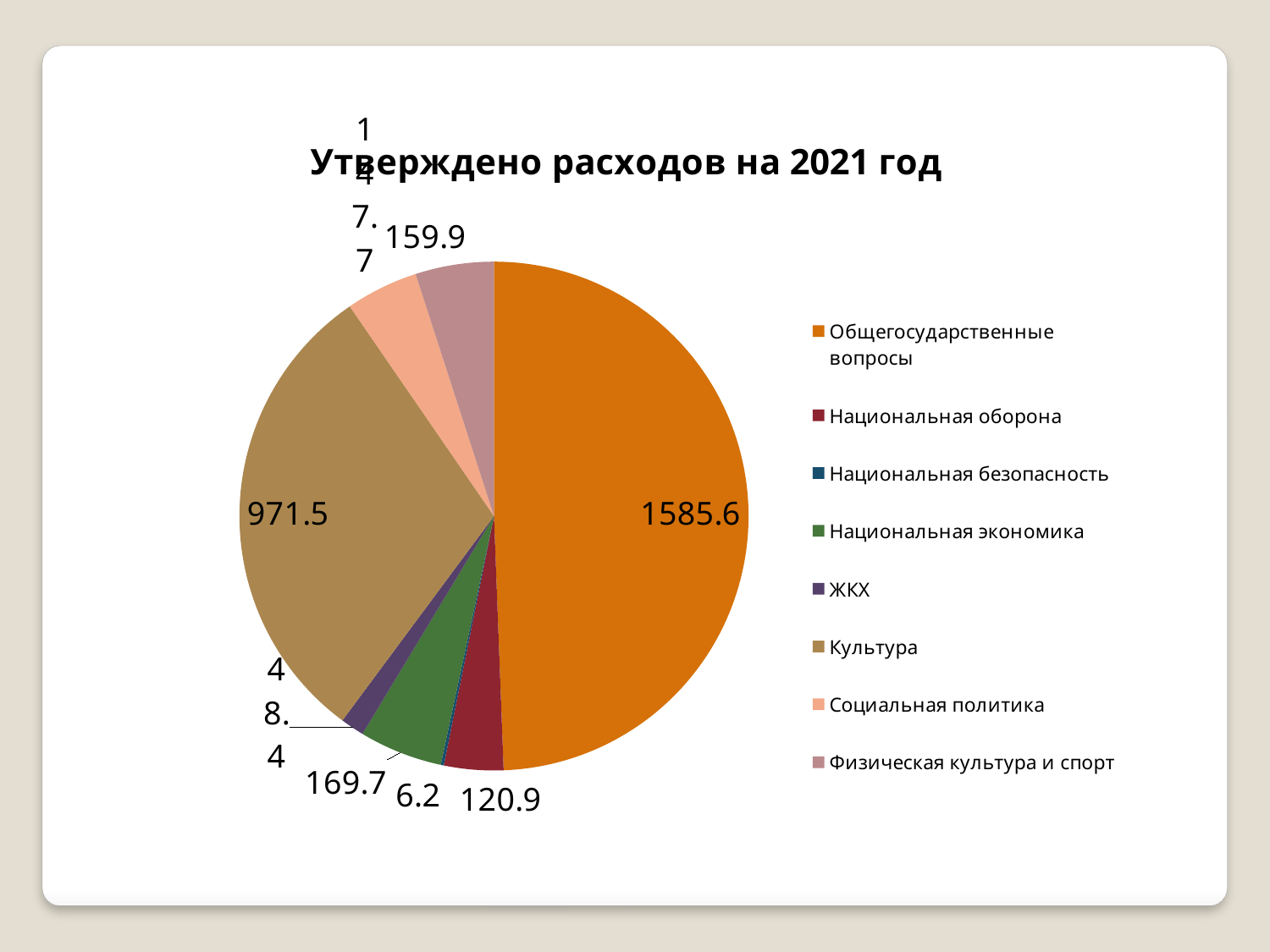
Which is larger, Национальная экономика or Национальная оборона? Национальная экономика How many categories does the legend list? 8 What is the difference between Общегосударственные вопросы and Культура? 614.1 What kind of chart is shown on the slide? pie chart Which category has the largest slice? Общегосударственные вопросы Which category has the smallest slice? Национальная безопасность What is the value for Национальная оборона? 120.9 What is the value for Культура? 971.5 What is the value for Физическая культура и спорт? 159.9 What is the title of the chart? Утверждено расходов на 2021 год What is the value for Общегосударственные вопросы? 1585.6 What is the value for Национальная экономика? 169.7